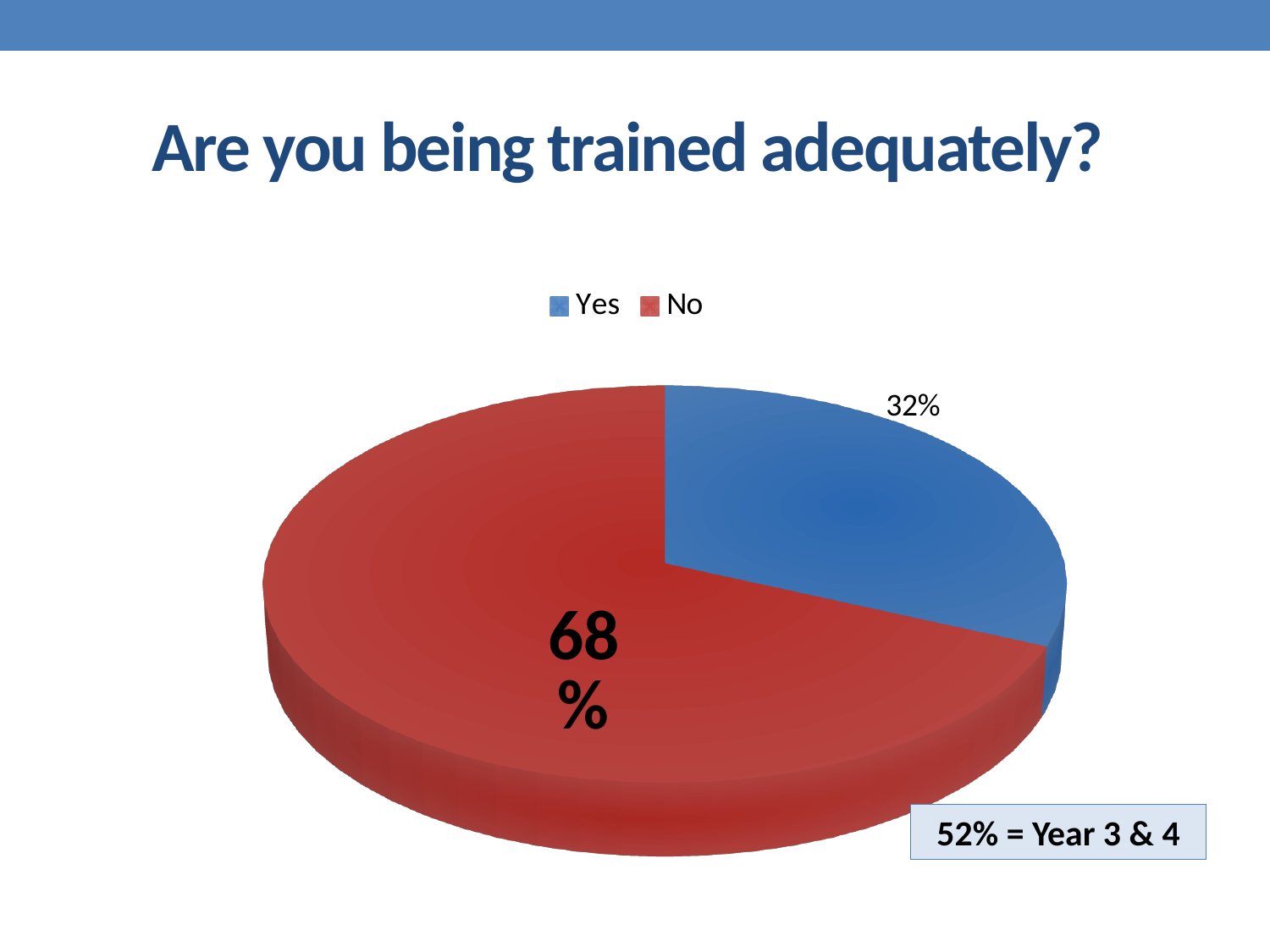
Which response has the largest share of the pie? No What is the title of the slide above the chart? Are you being trained adequately? What is the difference in percentage points between the No and Yes slices? 36 What share of the pie does the No slice represent? 68% Which is larger, the Yes slice or the No slice? No What percentage of respondents answered No? 68% How many entries does the legend list? 2 What percentage of respondents answered Yes? 32% What colour is the Yes slice? Blue What kind of chart is shown on the slide? Pie chart Which response has the smallest share of the pie? Yes How many slices does the pie chart have? 2